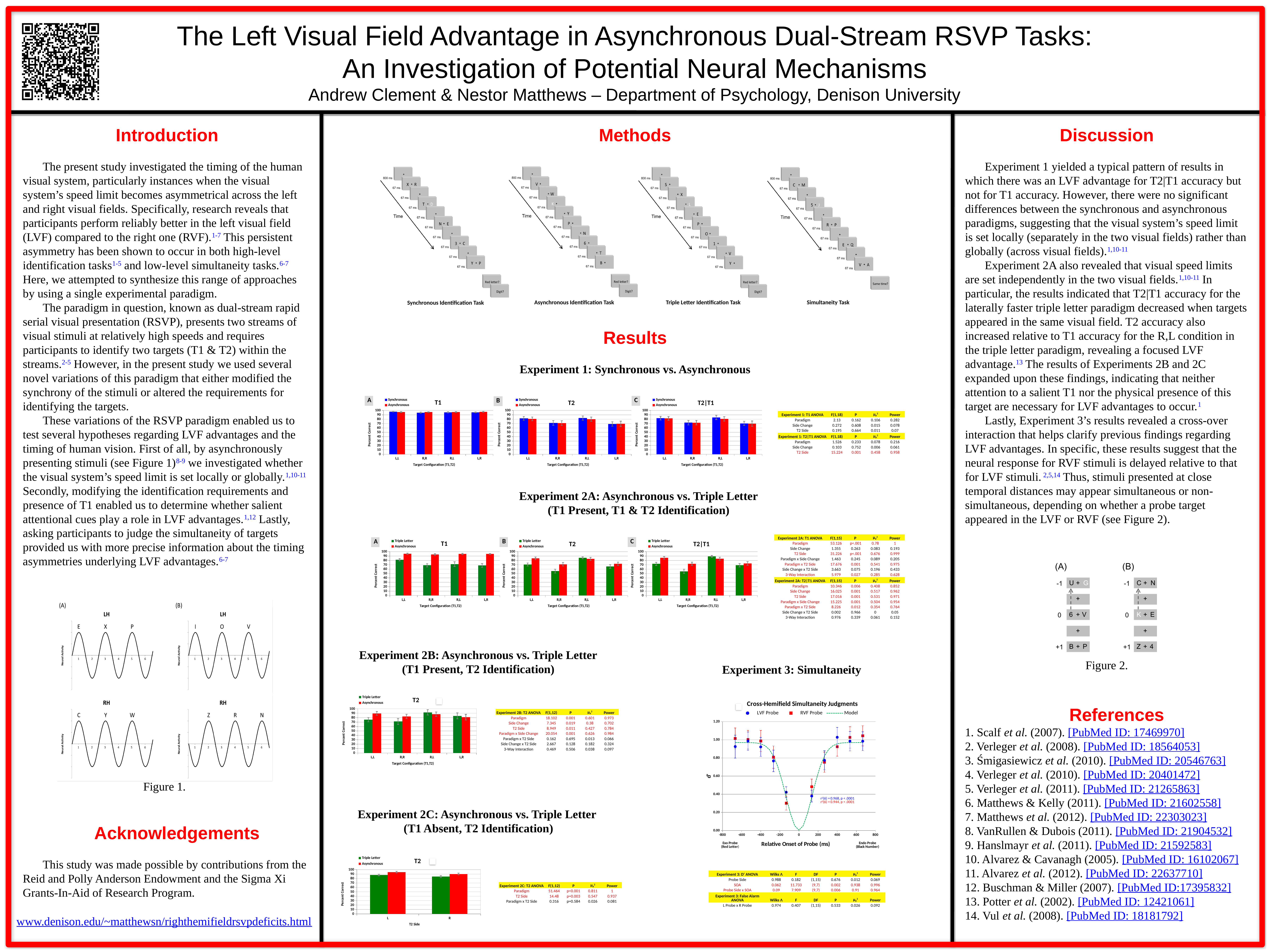
In the Experiment 2C T2 chart, is the Asynchronous value for L greater or less than 80? greater In the Experiment 2C T2 chart, how many T2 Side categories are shown on the x axis? 2 What kind of chart is the Experiment 1 T2 chart? Bar chart What is the label of the x axis in the Experiment 3 Cross-Hemifield Simultaneity Judgments chart? Relative Onset of Probe (ms) In the Experiment 2A T2 chart, which series is higher for the R,R configuration, Triple Letter or Asynchronous? Asynchronous In the Experiment 2A T2 chart, is the Triple Letter value for R,R greater or less than 70? less In the Experiment 2A T1 chart, which series is higher for the L,L configuration, Triple Letter or Asynchronous? Asynchronous In the Experiment 1 T1 chart, how many target configurations are shown on the x axis? 4 In the Experiment 1 T1 chart, is the Synchronous value for L,L greater or less than 80? greater In the Experiment 1 T1 chart, how many series does the legend list? 2 In the Experiment 3 Cross-Hemifield Simultaneity Judgments chart, how many entries does the legend list? 3